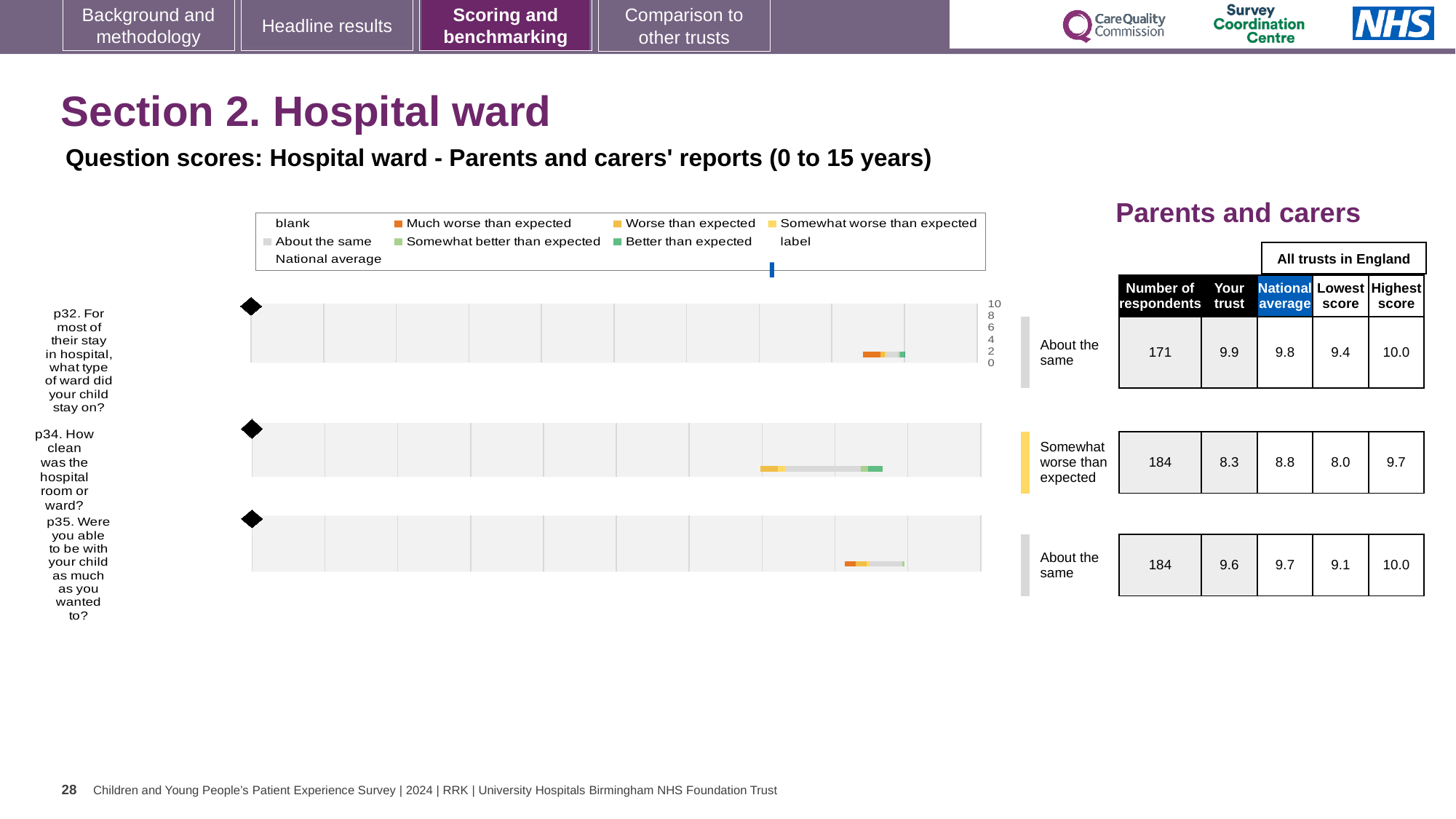
What is the national average score for p32 (what type of ward did your child stay on)? 9.8 What colour represents 'Better than expected' in the legend? Green How many respondents answered p32? 171 What is the 'Your trust' score for p34 (How clean was the hospital room or ward)? 8.3 For p34, which is larger: the 'Your trust' score or the national average? National average Which question has the lowest 'Your trust' score? p34 What kind of chart is used to show the question scores for the hospital ward section? Bar chart What is the highest score across all trusts in England for p35? 10.0 Which question has the highest 'Your trust' score? p32 How many questions (p-numbered categories) are plotted in the chart? 3 What benchmark category is p34 assigned to? Somewhat worse than expected What is the difference between the highest score and the lowest score for p34? 1.7